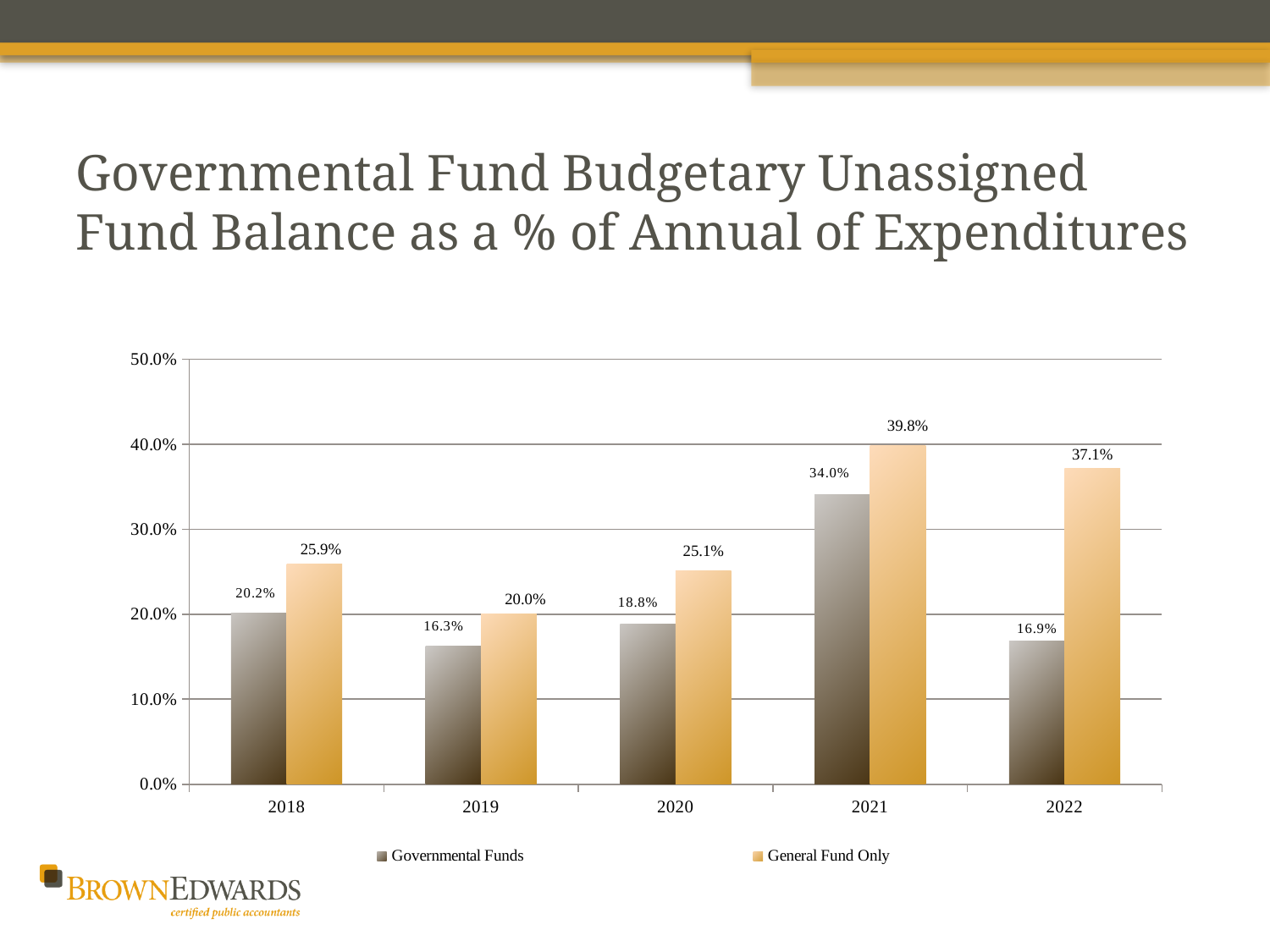
Is the Governmental Funds value for 2021 greater or less than 30.0%? greater How many series does the legend list? 2 What is the difference between the General Fund Only and Governmental Funds values in 2022? 20.2% What is the Governmental Funds value for 2018? 20.2% Which is larger in 2020: the Governmental Funds value or the General Fund Only value? General Fund Only Which year has the lowest Governmental Funds value? 2019 What is the Governmental Funds value for 2022? 16.9% How many years are shown on the x axis? 5 What is the General Fund Only value for 2021? 39.8% What kind of chart is shown on the slide? Bar chart Which year has the highest General Fund Only value? 2021 What are the two series named in the legend? Governmental Funds and General Fund Only